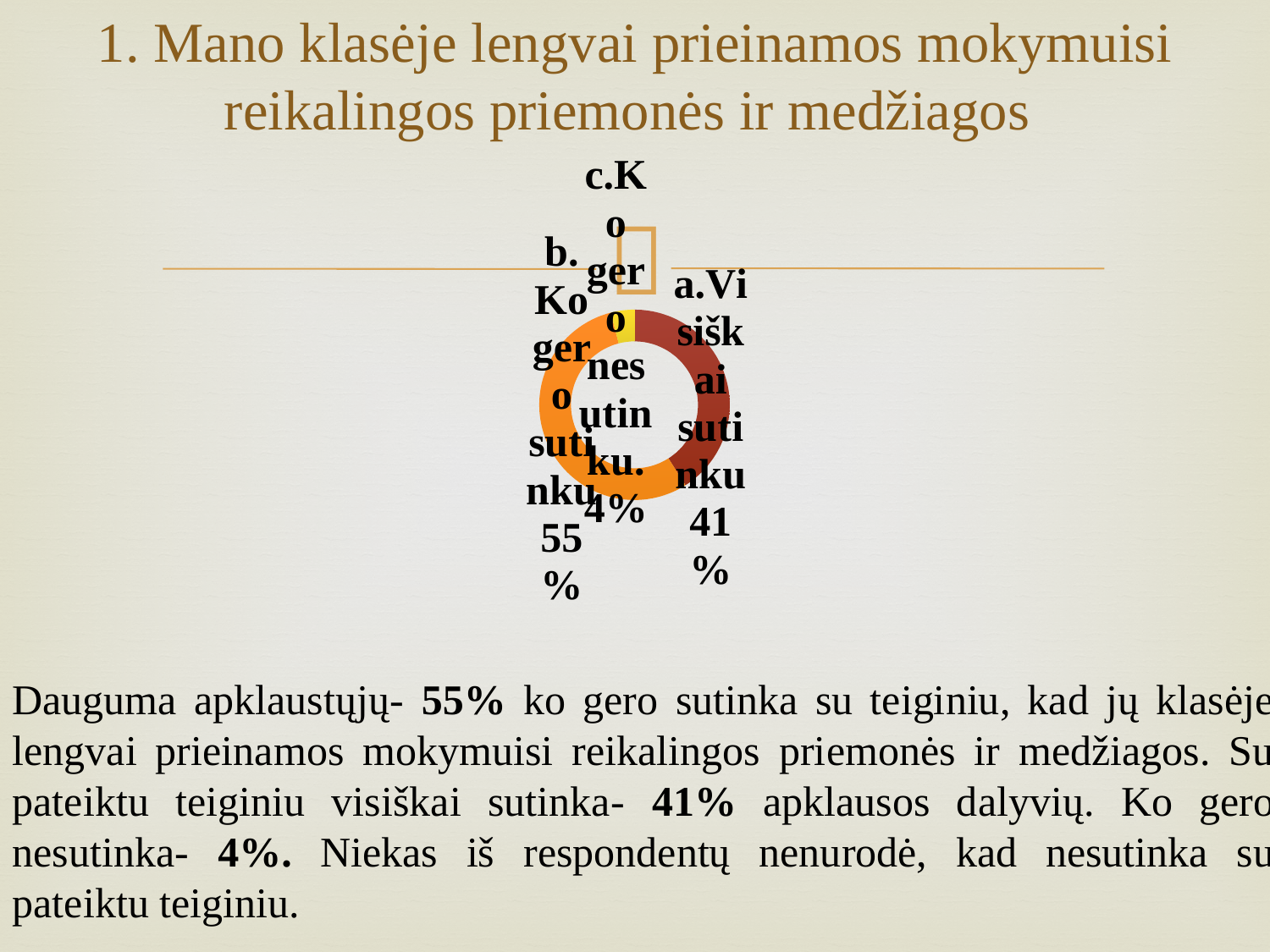
What is the title of the slide containing the chart? 1. Mano klasėje lengvai prieinamos mokymuisi reikalingos priemonės ir medžiagos What share of respondents chose "a. Visiškai sutinku"? 41% How many slices does the chart have? 3 Which is larger: the share for "a. Visiškai sutinku" or for "c. Ko gero nesutinku"? a. Visiškai sutinku What kind of chart is shown on the slide? Doughnut (pie) chart What share of respondents chose "c. Ko gero nesutinku"? 4% What is the combined share of "a. Visiškai sutinku" and "b. Ko gero sutinku"? 96% Which answer option has the smallest share in the chart? c. Ko gero nesutinku Which answer option has the largest share in the chart? b. Ko gero sutinku What is the difference in percentage points between "b. Ko gero sutinku" and "a. Visiškai sutinku"? 14 percentage points What colour is the slice for "b. Ko gero sutinku"? Orange What share of respondents chose "b. Ko gero sutinku"? 55%